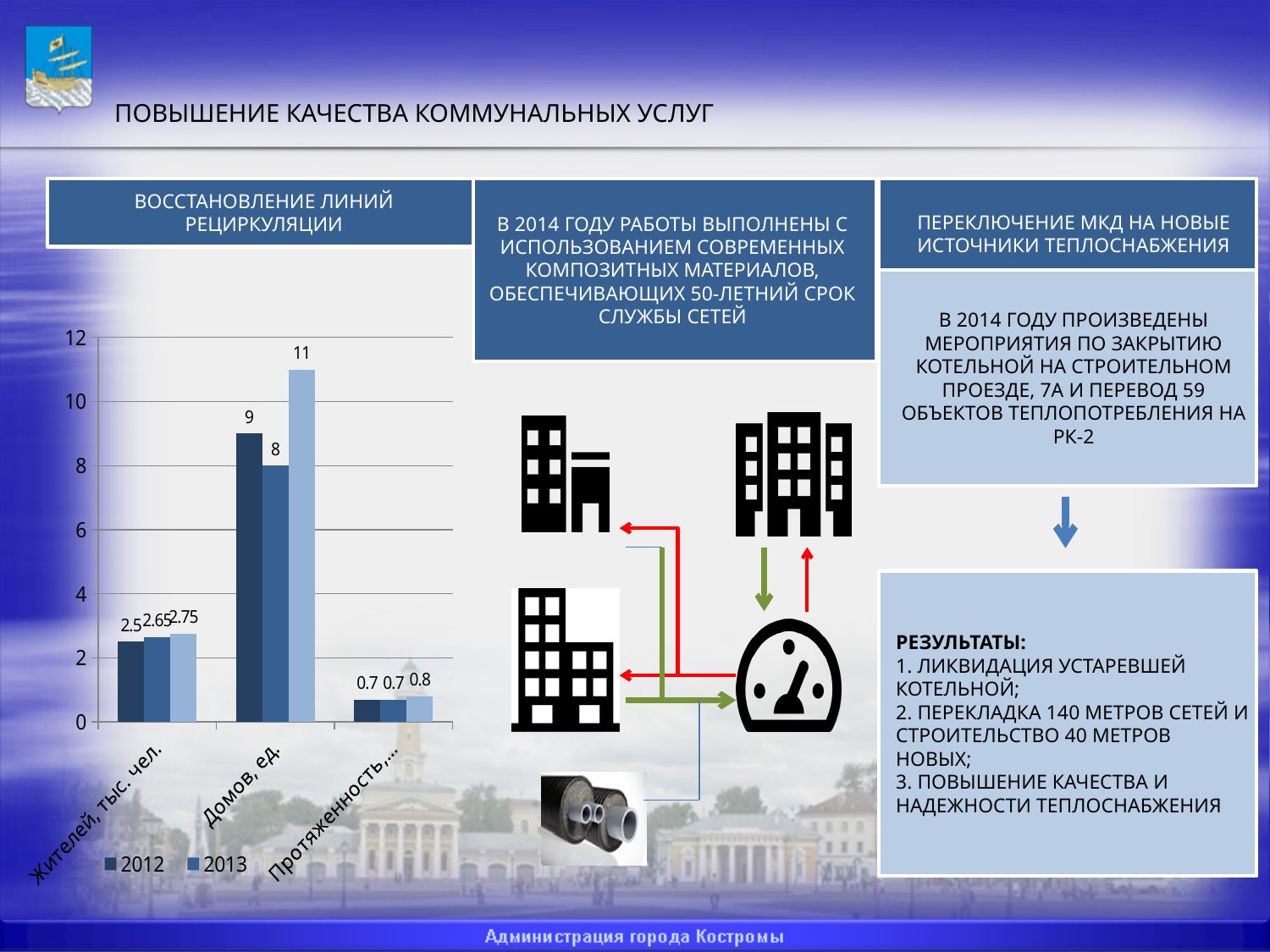
What is the 2013 value for "Жителей, тыс. чел."? 2.65 What type of chart is shown on the left of the slide? bar chart What is the title of the box above the chart? ВОССТАНОВЛЕНИЕ ЛИНИЙ РЕЦИРКУЛЯЦИИ What is the 2012 value for "Протяженность"? 0.7 What is the 2012 value for "Домов, ед."? 9 Which category has the highest 2012 value? Домов, ед. What is the difference between the 2012 and 2013 values for "Домов, ед."? 1 What is the 2012 value for "Жителей, тыс. чел."? 2.5 Which category has the lowest 2013 value? Протяженность Which is larger for "Домов, ед.": the 2012 value or the 2013 value? 2012 What is the 2013 value for "Домов, ед."? 8 How many categories are shown on the x axis of the chart? 3